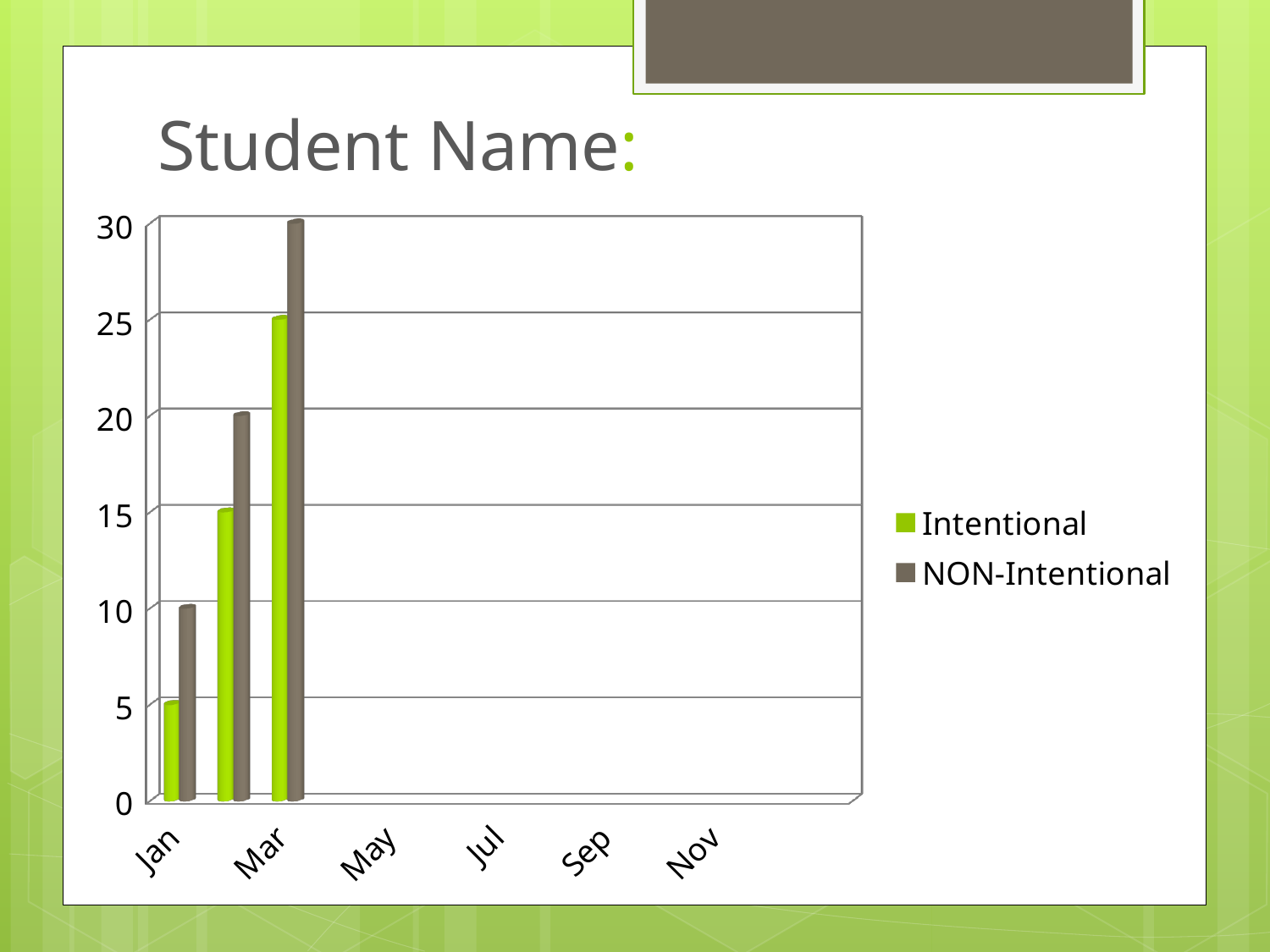
For Jan, which series has the larger value, Intentional or NON-Intentional? NON-Intentional What is the NON-Intentional value for Mar? 30 How many series does the legend list? 2 Do the Intentional values rise or fall from Jan to Mar? rise Which labelled month has the highest NON-Intentional value? Mar What is the Intentional value for Mar? 25 What kind of chart is shown on the slide? bar chart What are the two series named in the legend? Intentional and NON-Intentional What is the difference between the NON-Intentional and Intentional values for Mar? 5 What is the Intentional value for Jan? 5 How many month labels are shown on the x axis? 6 What is the NON-Intentional value for Jan? 10